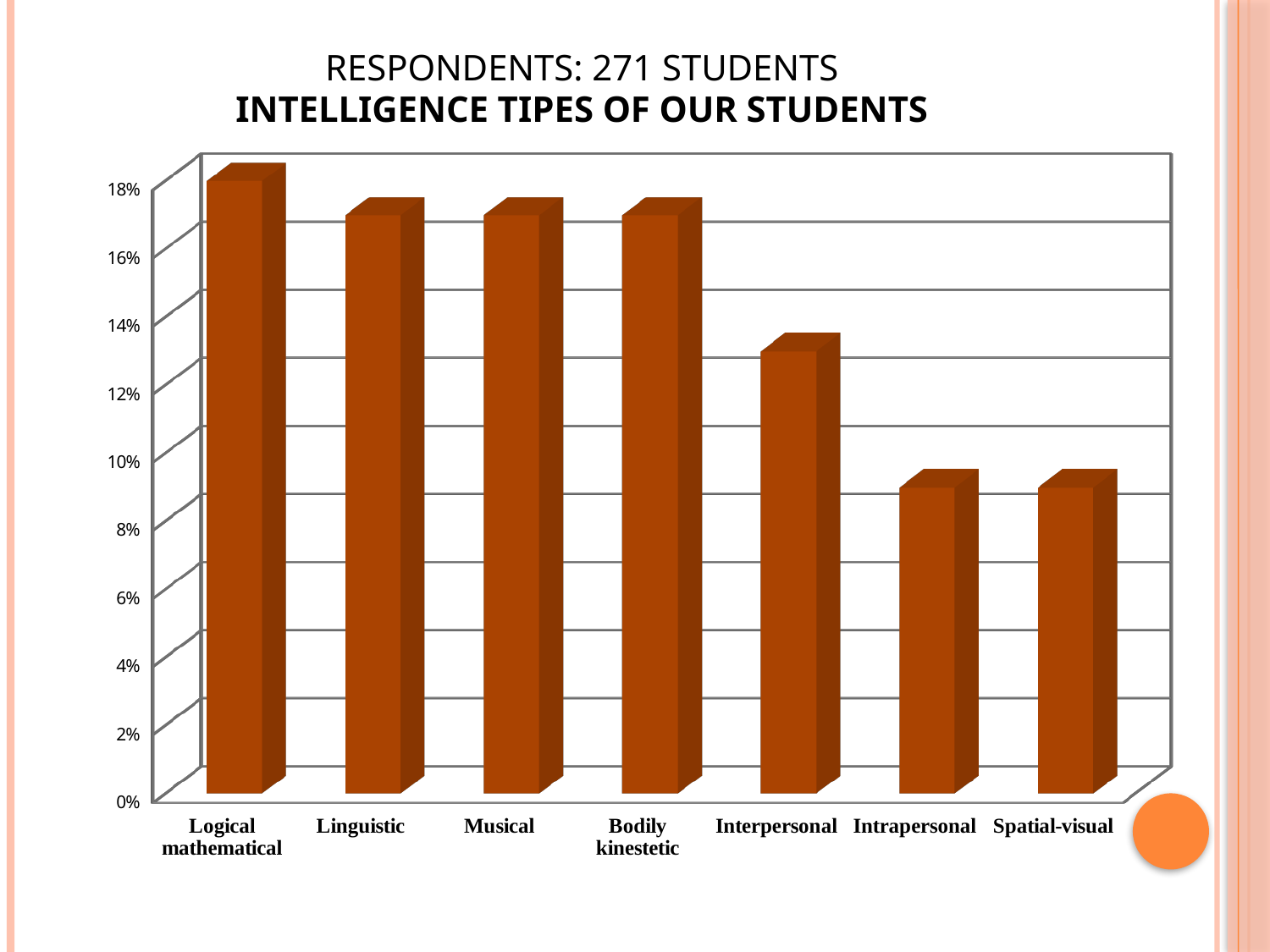
How many students responded, according to the slide heading? 271 students Do the values generally rise or fall moving from left to right along the x axis? fall Which is larger, the value for Bodily kinestetic or the value for Spatial-visual? Bodily kinestetic How many intelligence types (categories) are shown on the x axis? 7 Which intelligence type has the highest value? Logical mathematical Is the value for Interpersonal greater or less than 14%? less Is the value for Logical mathematical greater or less than 16%? greater Is the value for Spatial-visual greater or less than 10%? less Which is larger, the value for Interpersonal or the value for Intrapersonal? Interpersonal What kind of chart is shown on the slide? Bar chart